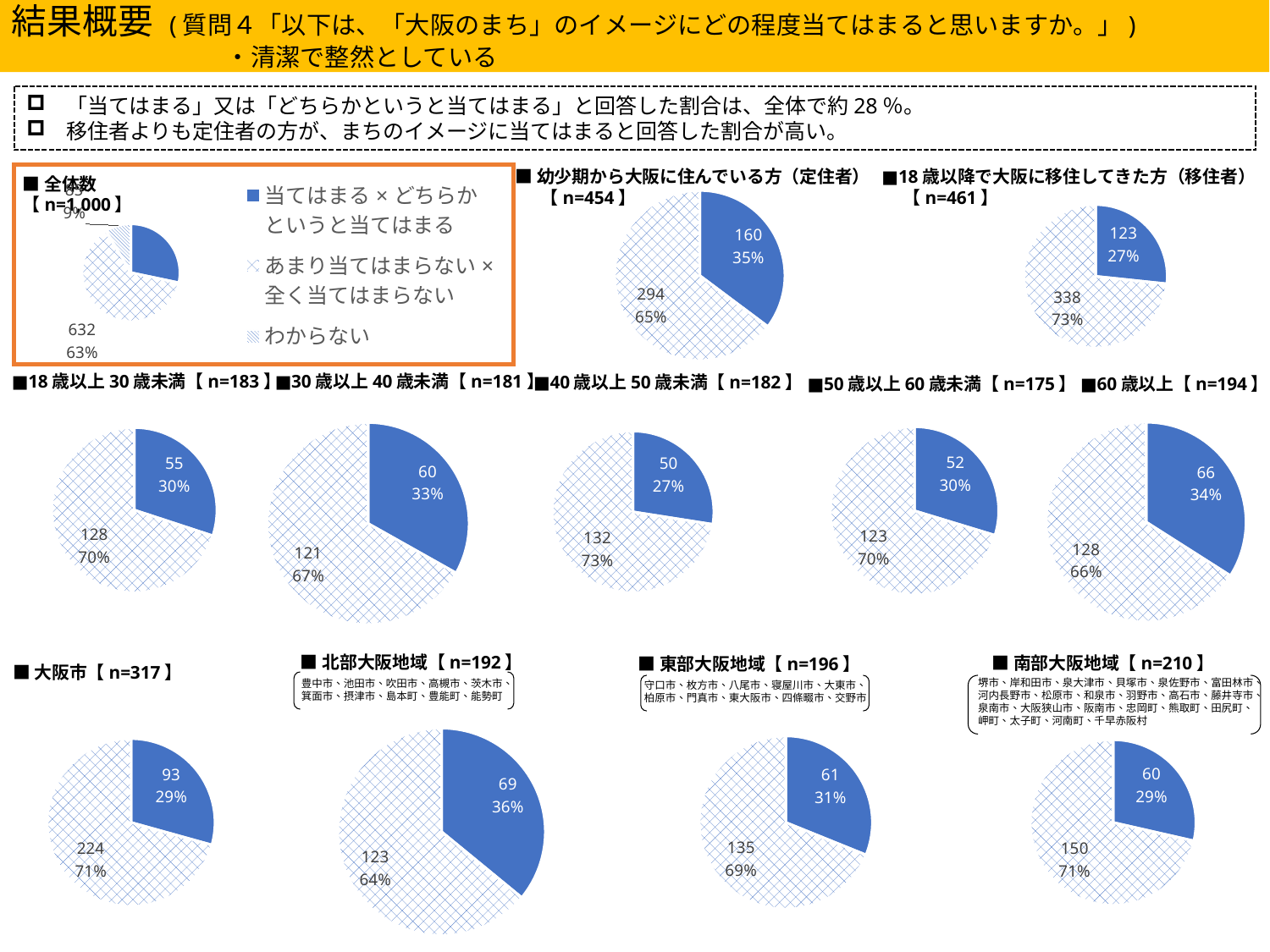
Among the five age-group charts (18歳以上30歳未満 to 60歳以上), which group has the highest percentage for 当てはまる × どちらかというと当てはまる? 60歳以上 How many entries does the legend in the 全体数 box list? 3 In the 幼少期から大阪に住んでいる方（定住者）【n=454】 chart, what percentage is shown for the 当てはまる × どちらかというと当てはまる slice? 35% What kind of chart is used for the 幼少期から大阪に住んでいる方（定住者） group? pie chart In the 60歳以上【n=194】 chart, how many respondents are in the 当てはまる × どちらかというと当てはまる slice? 66 In the 全体数【n=1,000】 chart, what percentage is shown for the あまり当てはまらない × 全く当てはまらない slice? 63% Among the five age-group charts, which group has the lowest percentage for 当てはまる × どちらかというと当てはまる? 40歳以上50歳未満 Which has a larger 当てはまる × どちらかというと当てはまる percentage: the 大阪市【n=317】 chart or the 北部大阪地域【n=192】 chart? 北部大阪地域 In the 18歳以降で大阪に移住してきた方（移住者）【n=461】 chart, how many respondents are in the あまり当てはまらない × 全く当てはまらない slice? 338 What is the difference in the 当てはまる × どちらかというと当てはまる percentage between the 定住者【n=454】 chart and the 移住者【n=461】 chart? 8 percentage points In the 東部大阪地域【n=196】 chart, what is the total of the two labelled slices (61 and 135)? 196 In the 北部大阪地域【n=192】 chart, what percentage is shown for the 当てはまる × どちらかというと当てはまる slice? 36%